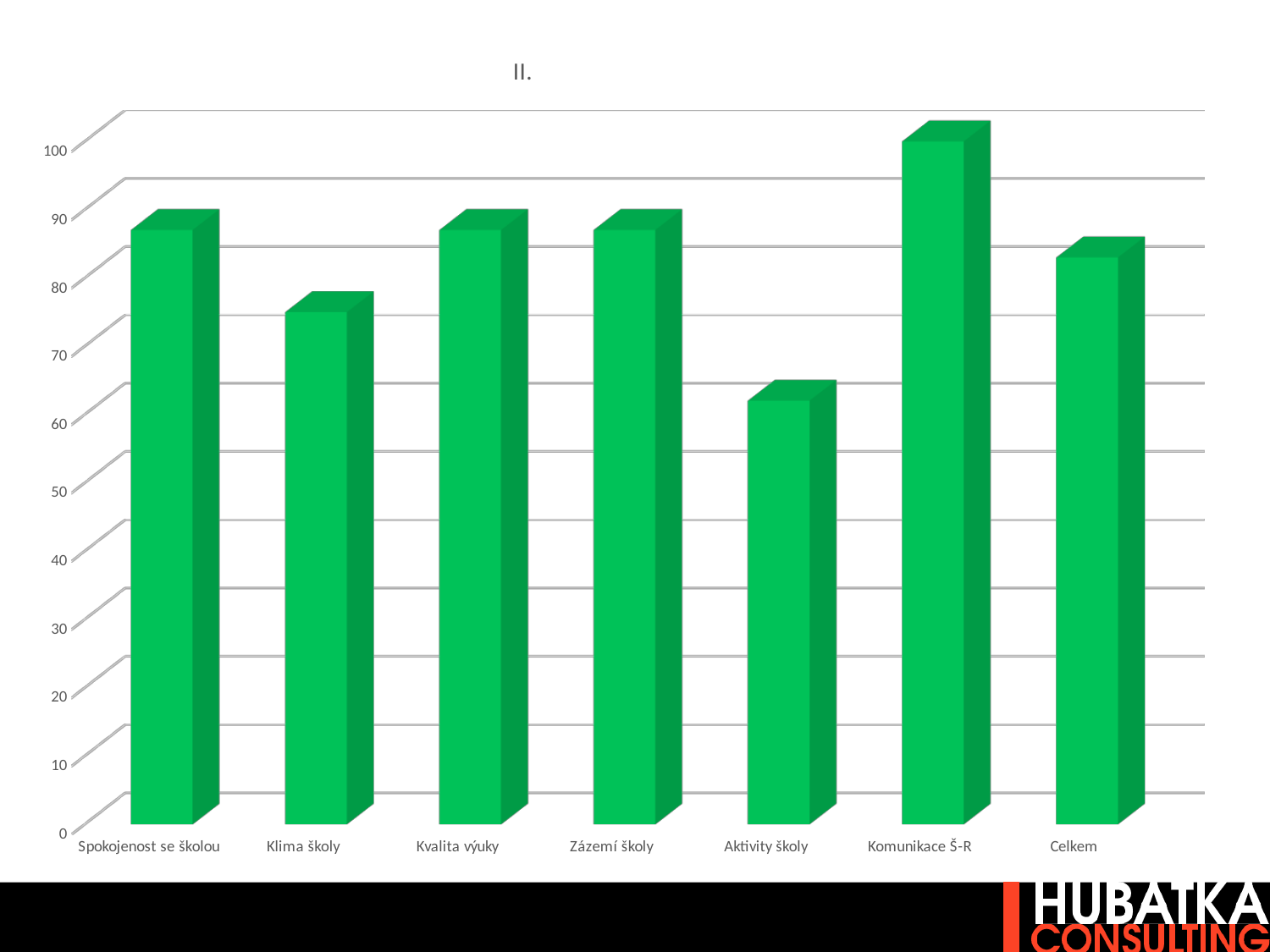
Is the value for Aktivity školy greater or less than 70? less Is the value for Komunikace Š-R greater or less than 90? greater Which is larger, the value for Spokojenost se školou or the value for Klima školy? Spokojenost se školou How many categories are shown on the x axis of the chart? 7 Is the value for Celkem greater or less than 70? greater What is the title of the chart? II. What kind of chart is shown on the slide? bar chart Which category has the lowest bar? Aktivity školy Which is larger, the value for Aktivity školy or the value for Celkem? Celkem Which category has the highest bar? Komunikace Š-R